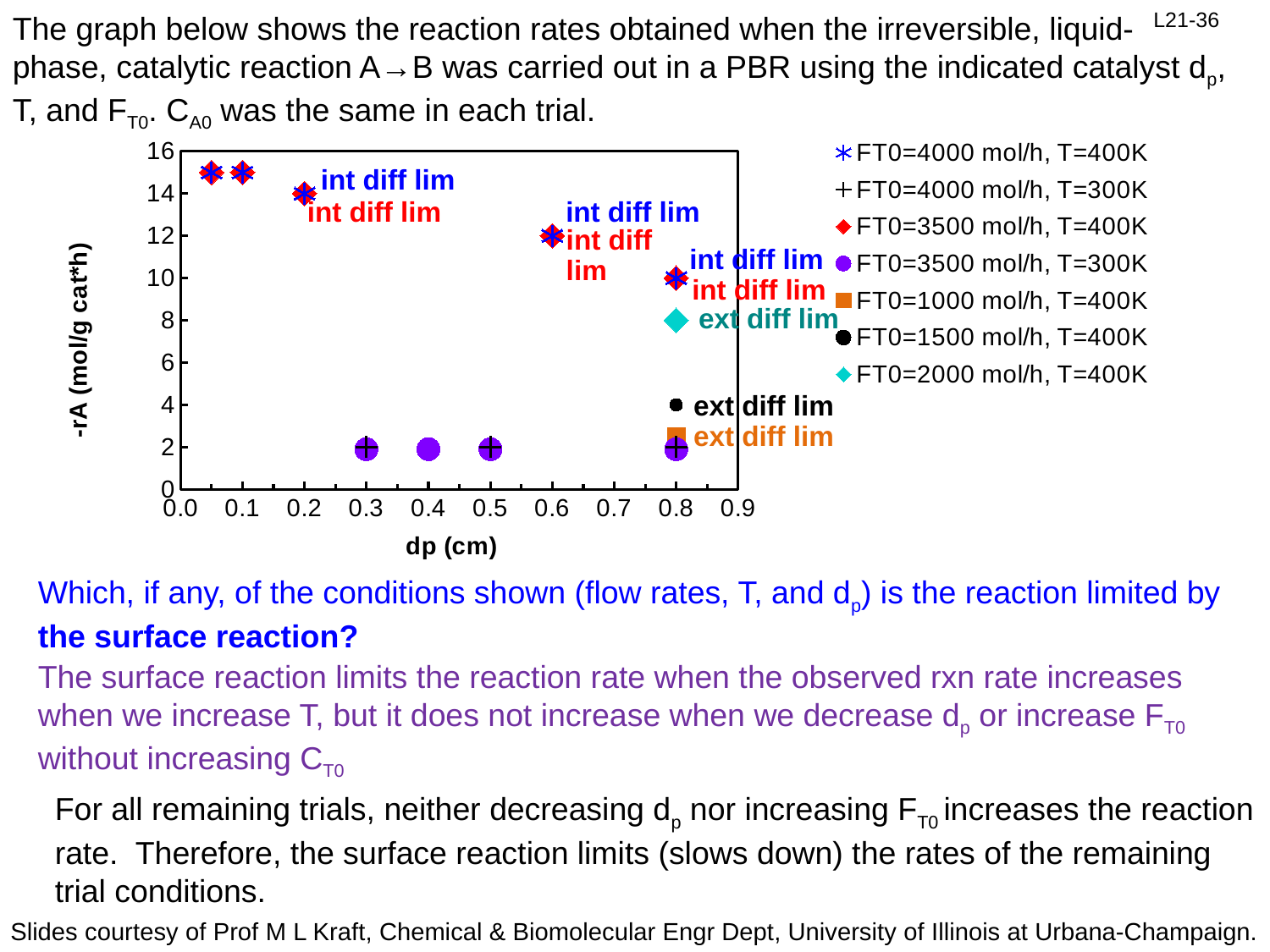
What is the reaction rate -rA for the FT0=4000 mol/h, T=400K series at dp = 0.8 cm? 10 What is the y-axis label of the chart? -rA (mol/g cat*h) For the FT0=4000 mol/h, T=400K series, does the reaction rate rise or fall as dp increases? fall What is the reaction rate -rA for the FT0=4000 mol/h, T=400K series at dp = 0.6 cm? 12 What is the reaction rate -rA for the FT0=1500 mol/h, T=400K series at dp = 0.8 cm? 4 What is the x-axis label of the chart? dp (cm) What is the reaction rate -rA for the FT0=2000 mol/h, T=400K series at dp = 0.8 cm? 8 Is the reaction rate for the FT0=3500 mol/h, T=300K series at dp = 0.4 cm greater or less than 4? less At dp = 0.8 cm, which series has a higher reaction rate: FT0=2000 mol/h, T=400K or FT0=1500 mol/h, T=400K? FT0=2000 mol/h, T=400K Is the reaction rate for the FT0=4000 mol/h, T=400K series at dp = 0.1 cm greater or less than 14? greater How many series does the legend list? 7 What kind of chart is shown on the slide? scatter plot